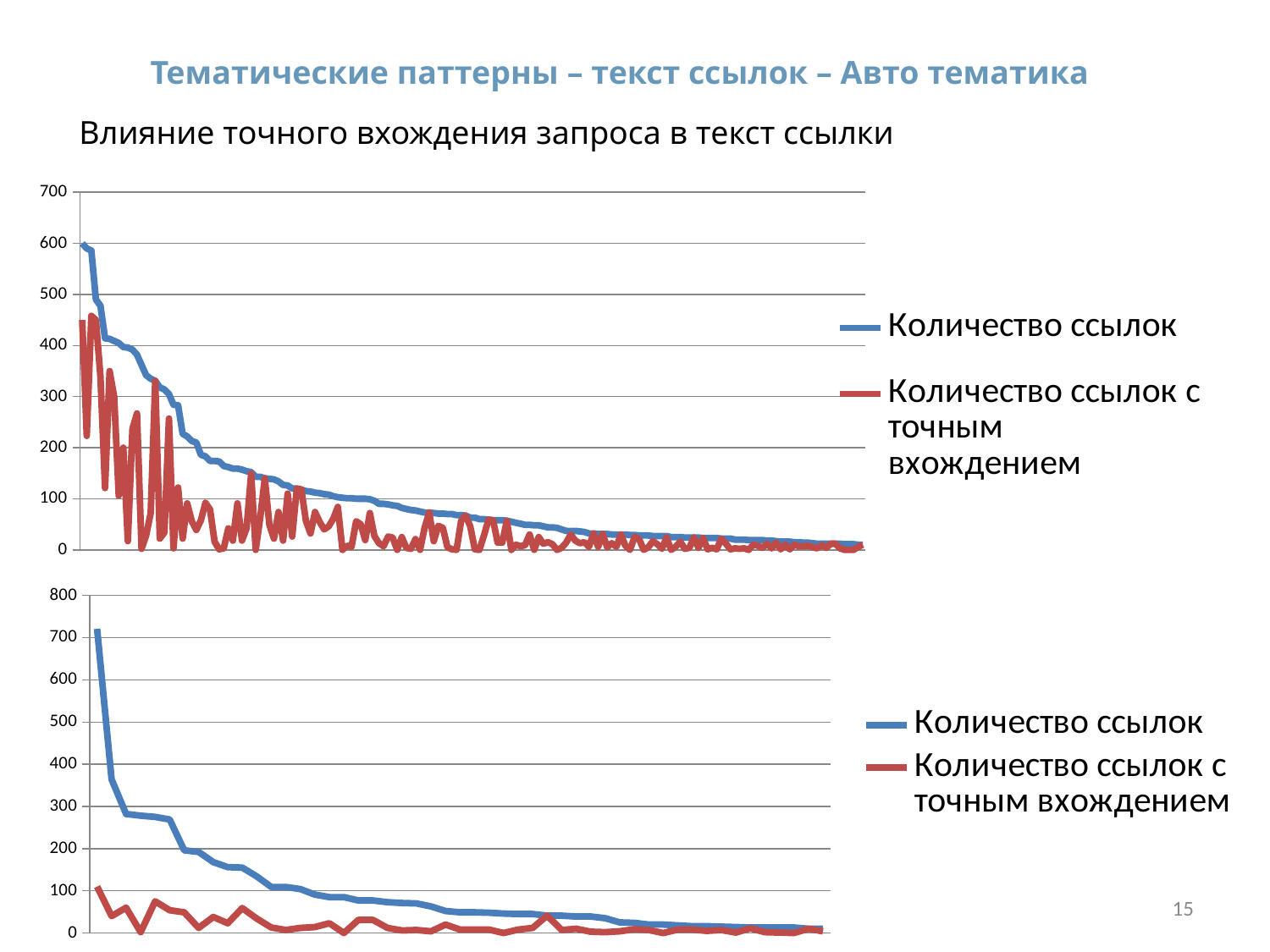
What kind of chart is the bottom chart on the slide? line chart In the bottom chart, does the blue 'Количество ссылок' line rise or fall along the x axis? fall In the bottom chart, is the highest value of the 'Количество ссылок' line greater or less than 600? greater In the top chart, which colour is used for the 'Количество ссылок с точным вхождением' series? red In the bottom chart, which series reaches the higher values: 'Количество ссылок' or 'Количество ссылок с точным вхождением'? Количество ссылок In the top chart, is the highest value of the 'Количество ссылок' line greater or less than 500? greater How many series does the legend of the top chart list? 2 How many series does the legend of the bottom chart list? 2 What kind of chart is the top chart on the slide? line chart In the top chart, does the blue 'Количество ссылок' line rise or fall along the x axis? fall In the top chart, is the highest value of the 'Количество ссылок с точным вхождением' line greater or less than 500? less